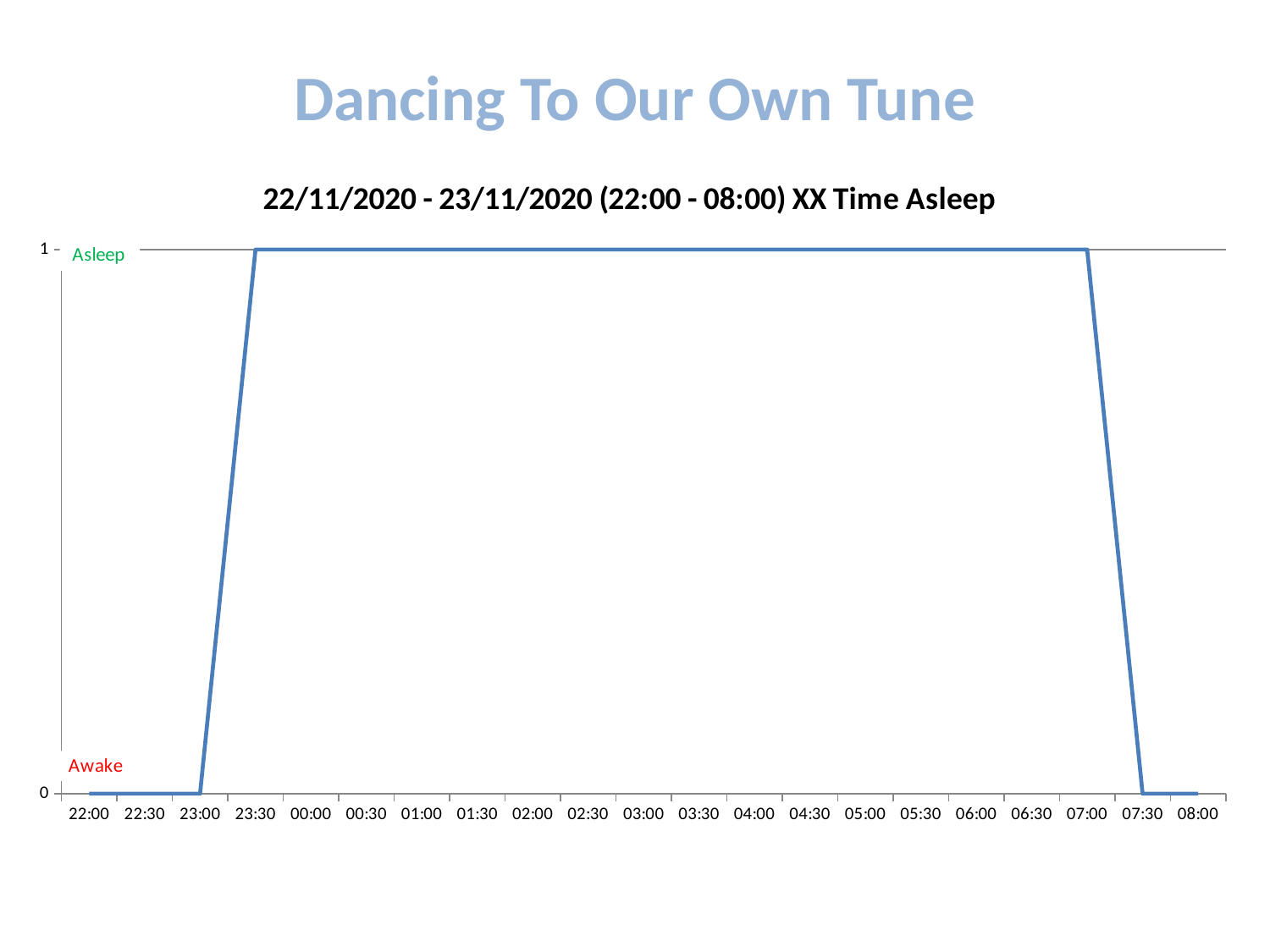
Which of the two values is larger, the one at 23:00 or the one at 23:30? 23:30 What is the title of the chart? 22/11/2020 - 23/11/2020 (22:00 - 08:00) XX Time Asleep How many time points are labelled along the x axis? 21 What is the value plotted at 23:30? 1 Does the line rise or fall between 07:00 and 07:30? fall What label is shown next to the value 1 on the y axis? Asleep What is the value plotted at 03:00? 1 What kind of chart is shown on the slide? line chart What is the value plotted at 07:30? 0 What is the value plotted at 08:00? 0 What is the difference between the value at 07:00 and the value at 07:30? 1 What is the value plotted at 22:00? 0